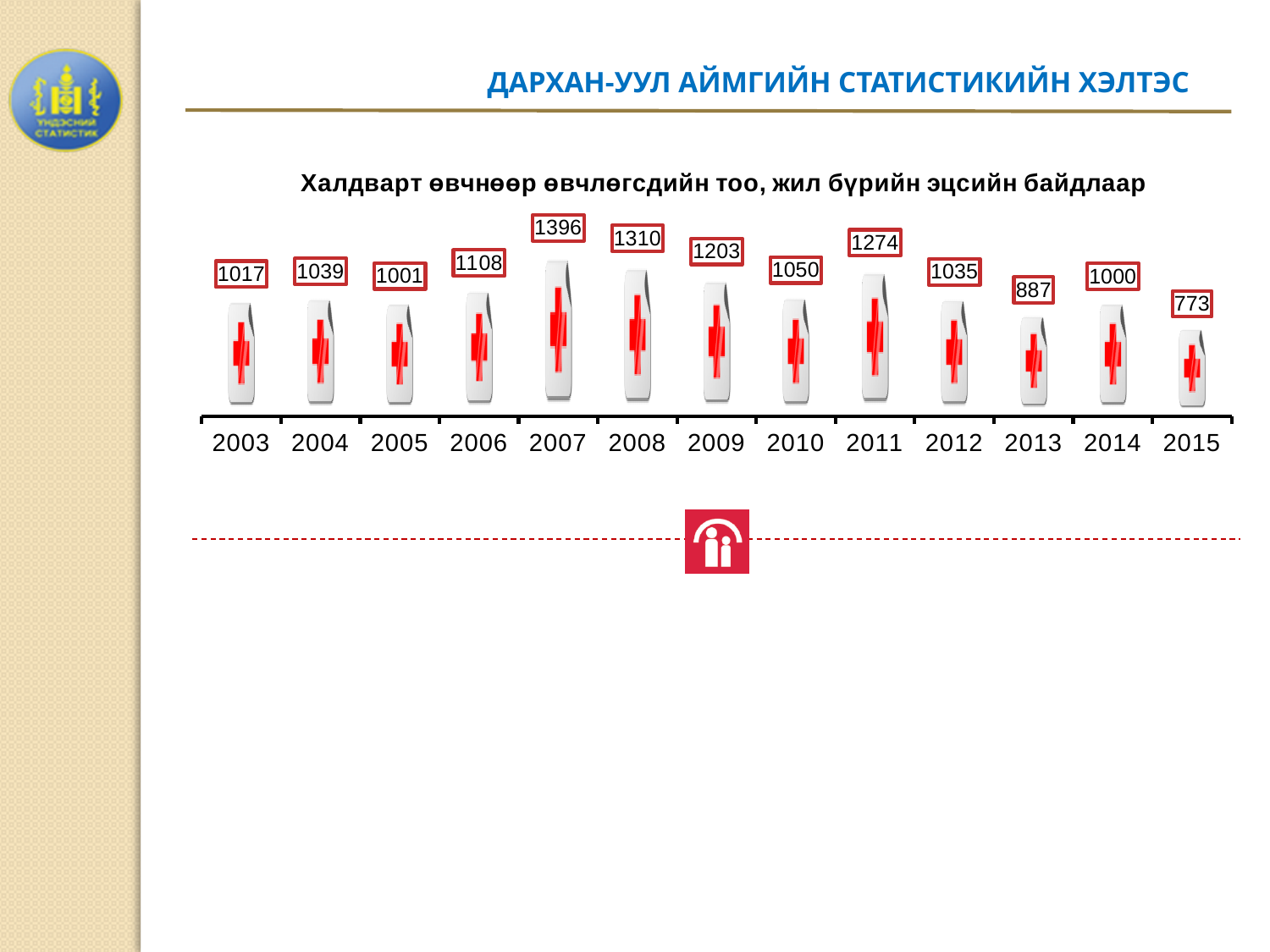
Which year has the lowest value? 2015 What kind of chart is this? bar chart Which is larger, the value for 2008 or the value for 2011? 2008 What is the value for 2015? 773 What is the value for 2011? 1274 What is the difference between the values for 2007 and 2015? 623 What is the value for 2007? 1396 How many years are shown on the x axis? 13 What is the title of the chart? Халдварт өвчнөөр өвчлөгсдийн тоо, жил бүрийн эцсийн байдлаар Which year has the highest value? 2007 Do the values rise or fall from 2011 to 2015? fall What is the difference between the values for 2013 and 2014? 113